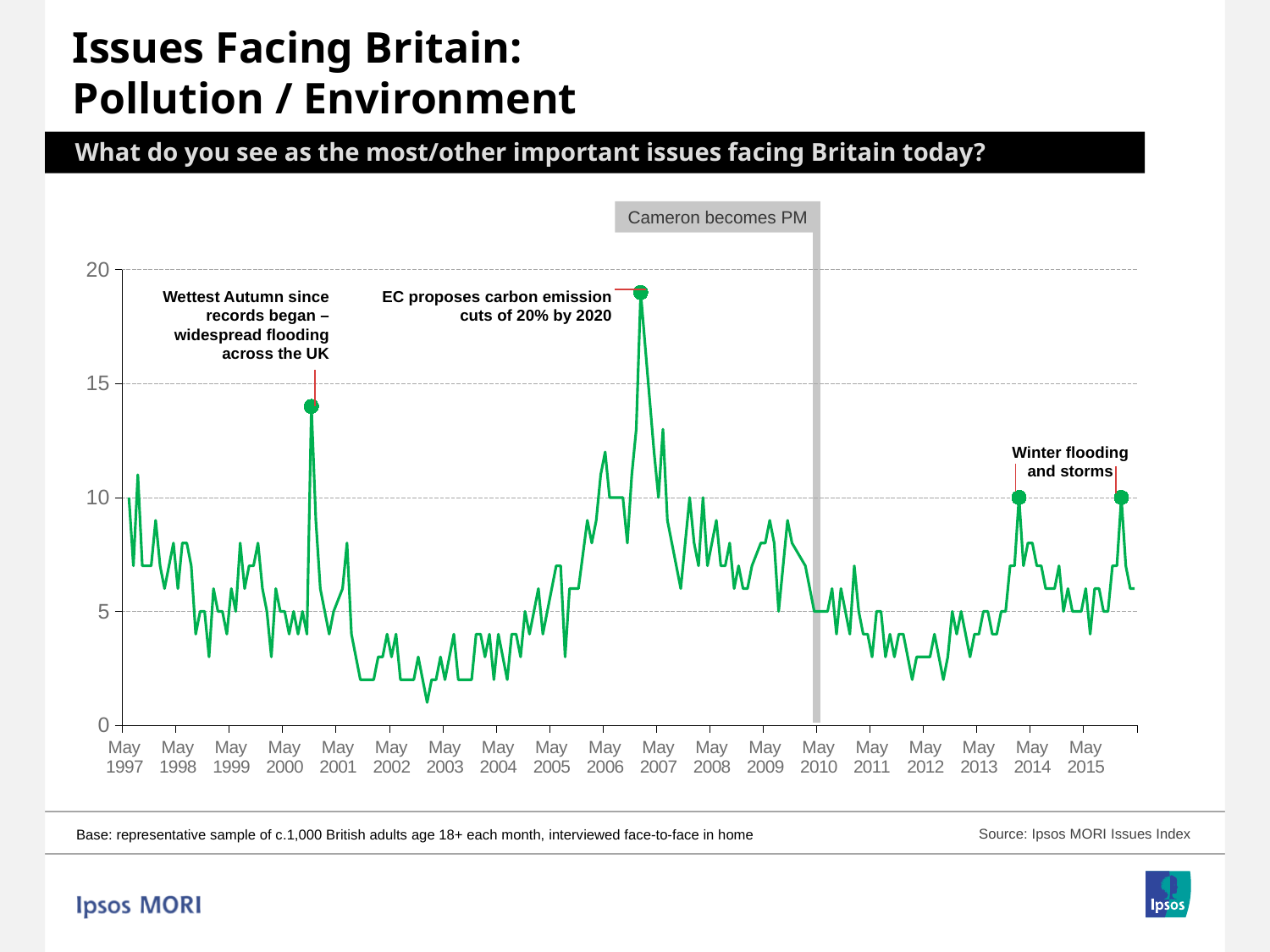
Which annotated event coincides with the highest point on the line? EC proposes carbon emission cuts of 20% by 2020 What event does the vertical grey bar on the chart mark? Cameron becomes PM Which is higher: the peak marked 'Wettest Autumn since records began' or the peak marked 'Winter flooding and storms'? Wettest Autumn since records began What is the highest value shown on the y axis? 20 Is the peak marked 'Wettest Autumn since records began' greater or less than 10? greater What kind of chart is shown on the slide? line chart Is the value around May 2012 greater or less than 5? less Is the value around May 2003 greater or less than 5? less Do the values generally rise or fall between May 2012 and May 2014? rise